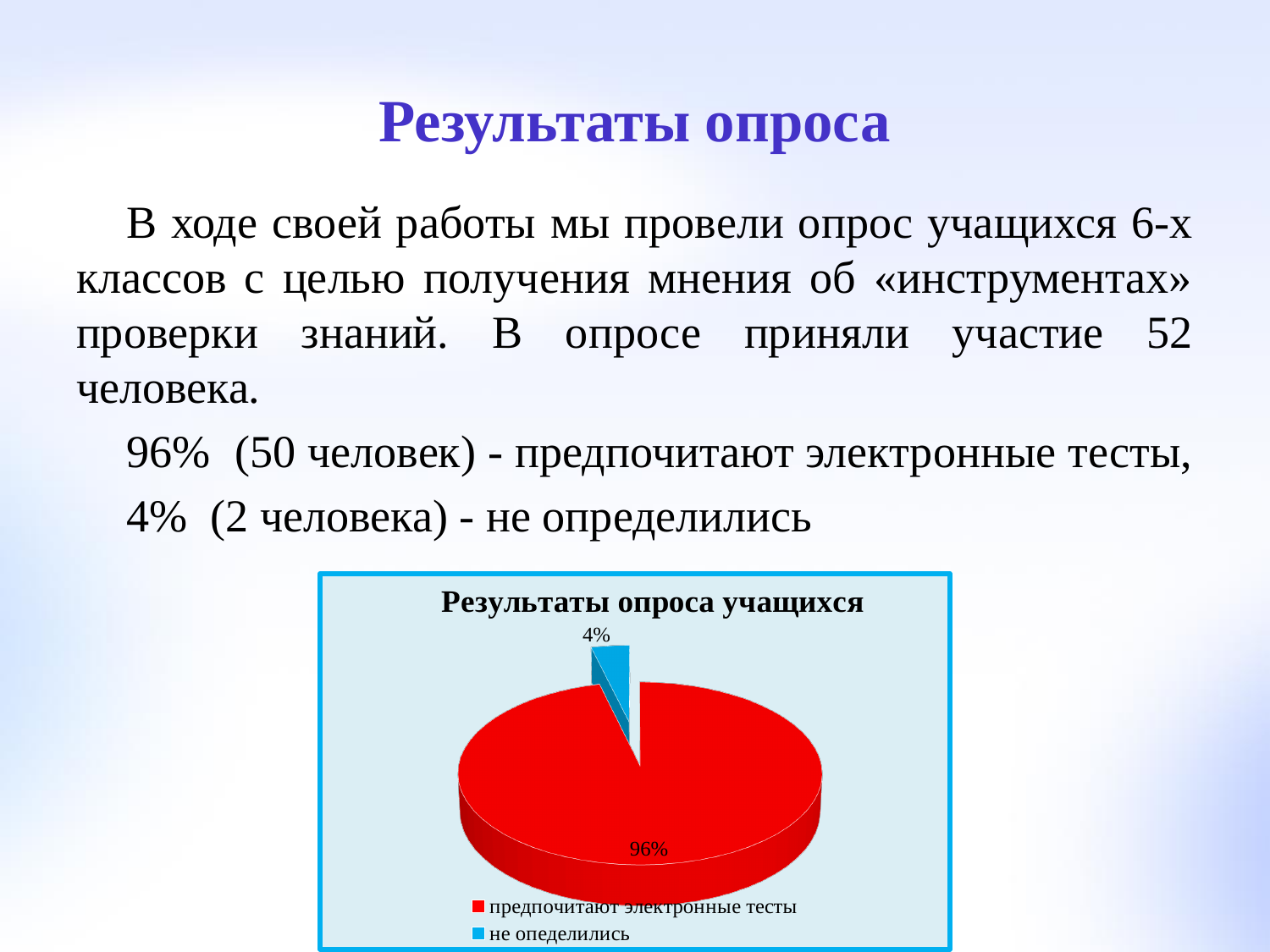
What kind of chart is shown on the slide? pie chart What is the title of the chart? Результаты опроса учащихся What share of the pie is labelled "предпочитают электронные тесты"? 96% What colour is the slice for "не опеделились"? blue How many slices does the pie chart have? 2 Which slice is larger: "предпочитают электронные тесты" or "не опеделились"? предпочитают электронные тесты How many entries does the legend list? 2 Which category has the smallest slice of the pie? не опеделились What is the difference in percentage points between the "предпочитают электронные тесты" slice and the "не опеделились" slice? 92 What share of the pie is labelled "не опеделились"? 4% Which category has the largest slice of the pie? предпочитают электронные тесты